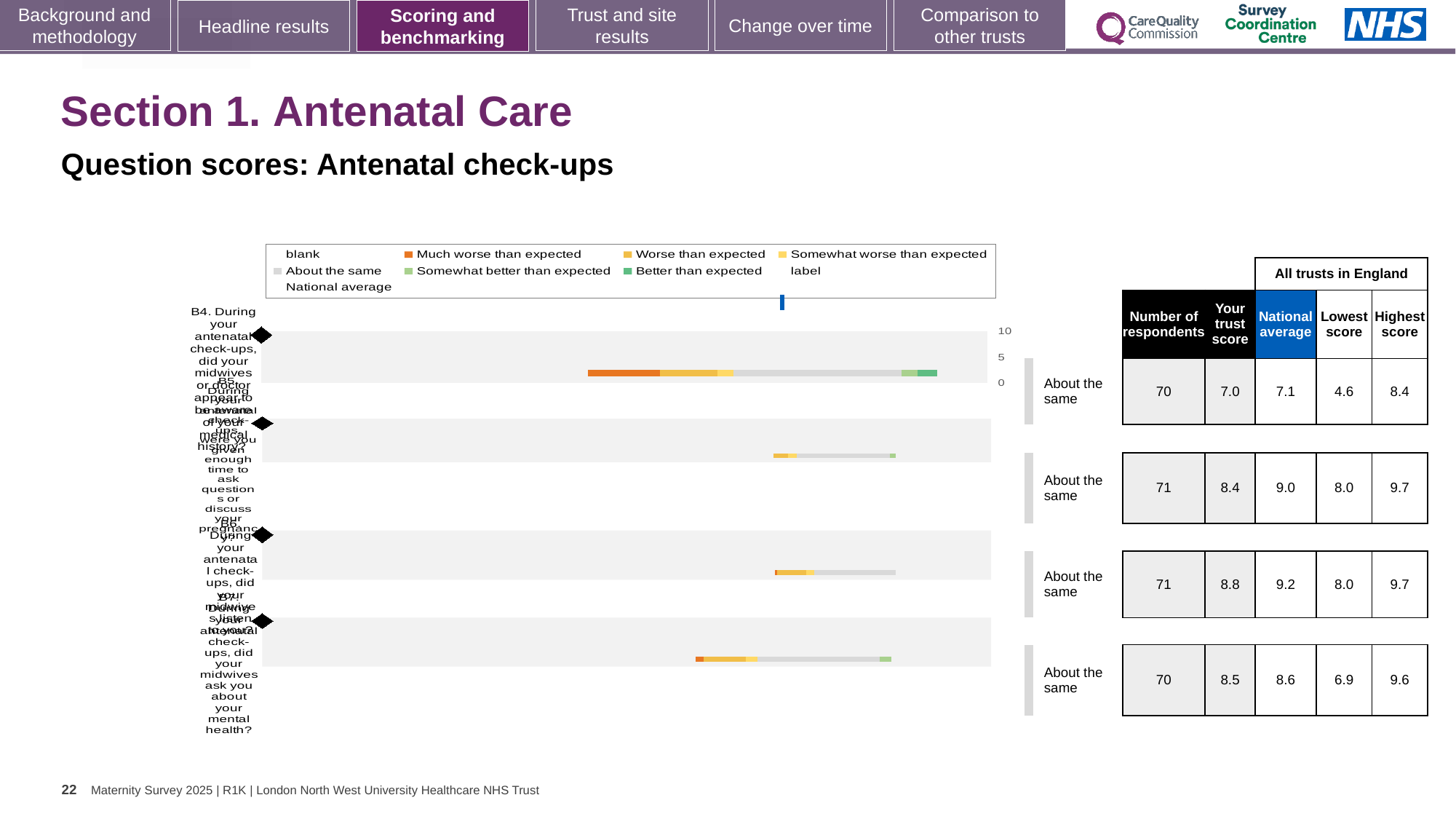
Which legend entry is shown in dark orange? Much worse than expected What kind of chart is shown on the slide? bar chart What is the national average for question B5 (enough time to ask questions)? 9.0 What is the trust score for question B4 (awareness of medical history)? 7.0 How many question rows (bars) does the chart show? 4 How many respondents answered question B6 (did your midwives listen to you)? 71 What is the difference between the national average and the trust score for question B4? 0.1 Which question has the highest trust score? B6 Which is larger: the trust score for B5 or the trust score for B7? B7 Which question has the lowest trust score? B4 How many entries does the chart legend list? 9 What is the highest score across all trusts in England for question B7 (asked about mental health)? 9.6